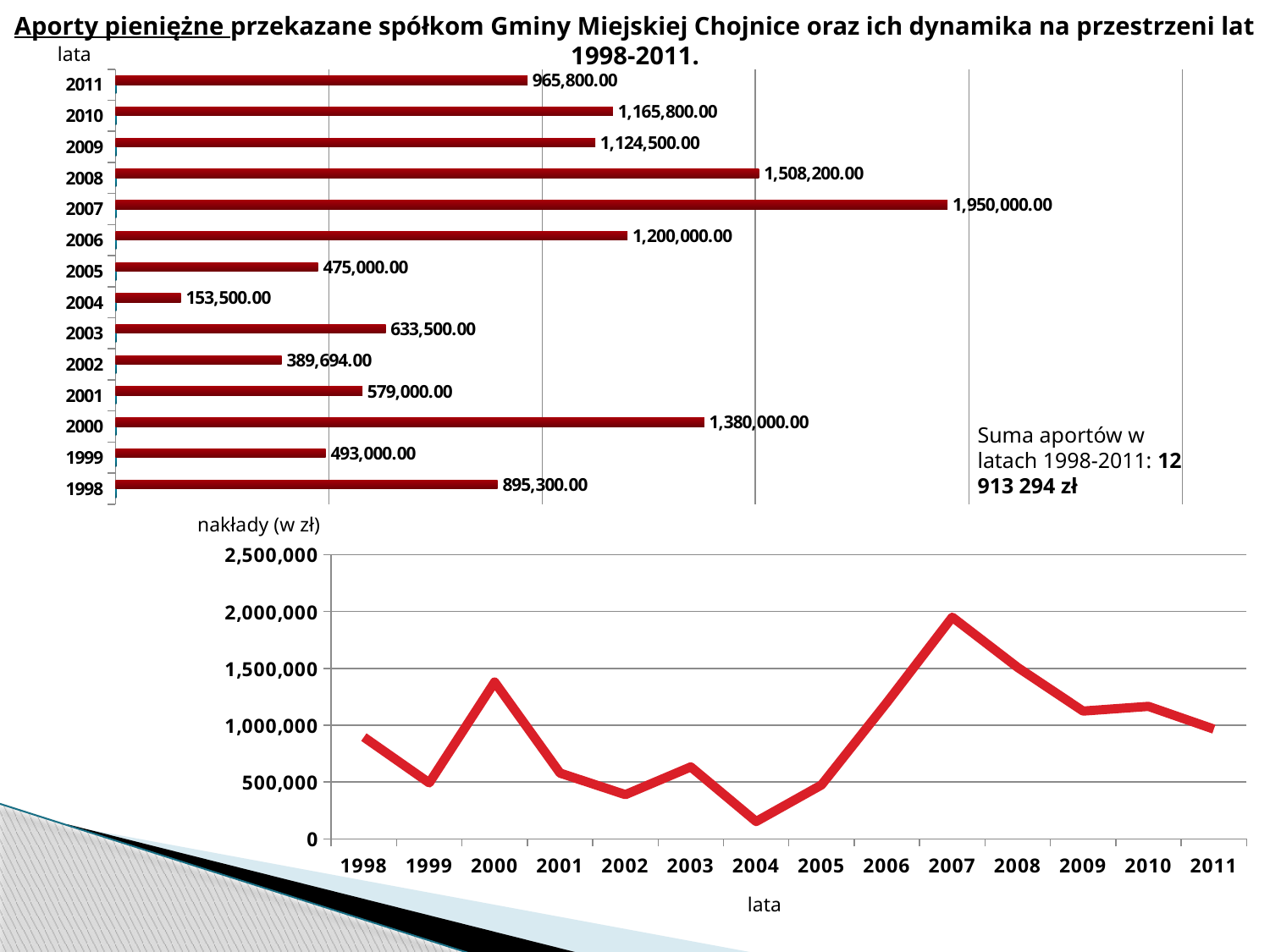
In the bottom line chart, do the values rise or fall from 2004 to 2007? rise How many years are shown in the top bar chart? 14 In the top bar chart, what is the value for 2007? 1,950,000.00 In the bottom line chart, is the value for 2007 greater or less than 1,500,000? greater What kind of chart is the bottom chart on the slide? line chart What kind of chart is the top chart on the slide? bar chart In the top bar chart, which year has the lowest value? 2004 In the top bar chart, what is the difference between the values for 2007 and 2008? 441,800.00 In the top bar chart, what is the value for 2002? 389,694.00 In the top bar chart, what is the value for 1998? 895,300.00 In the top bar chart, which is larger, the value for 2000 or the value for 2006? 2000 In the top bar chart, which year has the highest value? 2007